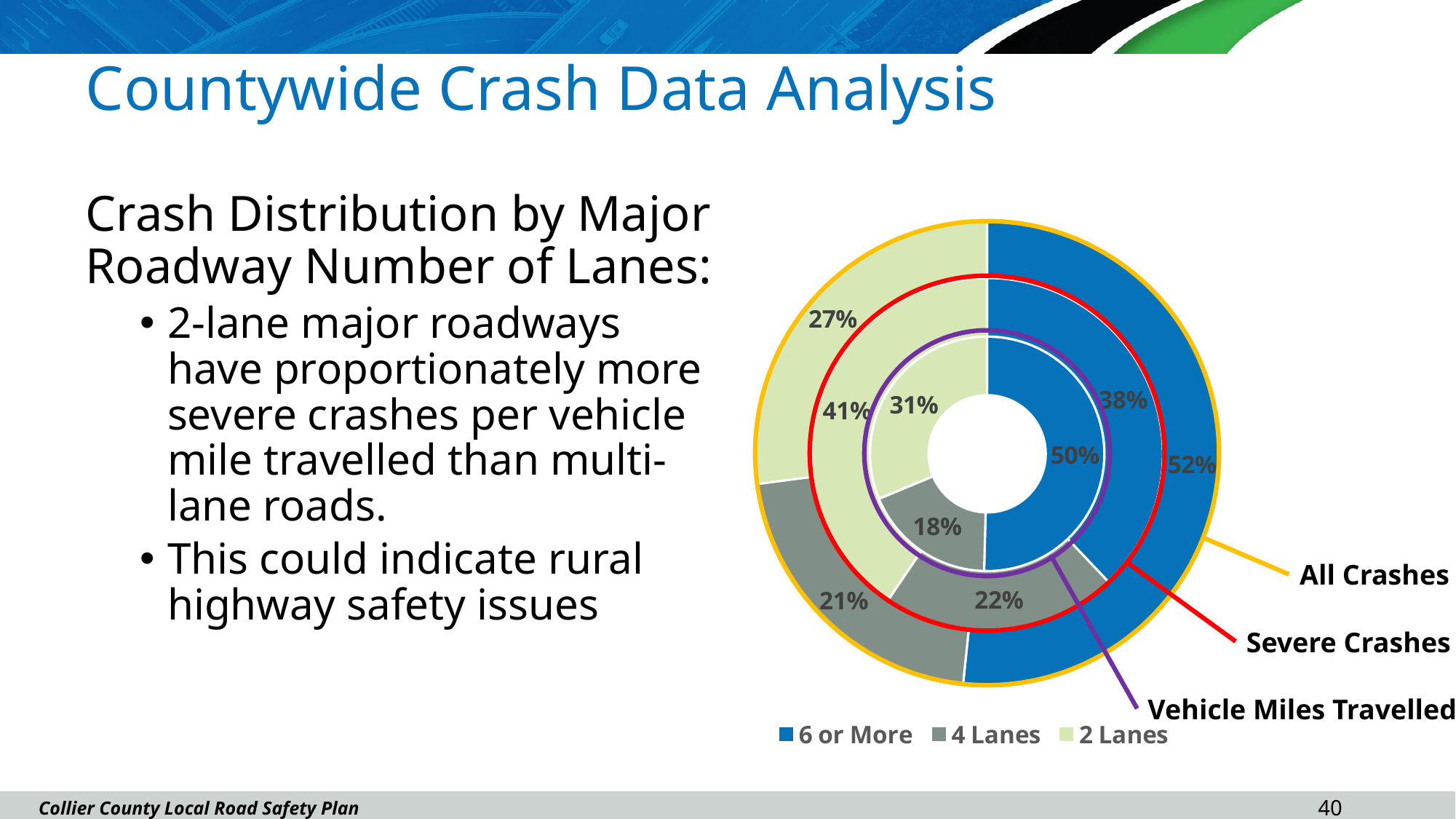
How many lane categories does the legend list? 3 Which ring of the chart is outlined in red? Severe Crashes What colour represents the 2 Lanes category in the legend? Light green In the All Crashes ring, what share is on 4 Lanes roadways? 21% Which lane category has the smallest share of Vehicle Miles Travelled? 4 Lanes What is the difference between the 2 Lanes share of Severe Crashes and the 2 Lanes share of Vehicle Miles Travelled? 10% In the All Crashes ring, what share of crashes is on roadways with 6 or More lanes? 52% In the Vehicle Miles Travelled ring, what share is on 4 Lanes roadways? 18% Which lane category has the largest share of Severe Crashes? 2 Lanes Which is larger: the 6 or More share of All Crashes or the 6 or More share of Severe Crashes? All Crashes In the Severe Crashes ring, what share is on 2 Lanes roadways? 41% What kind of chart is shown on the slide? Doughnut chart